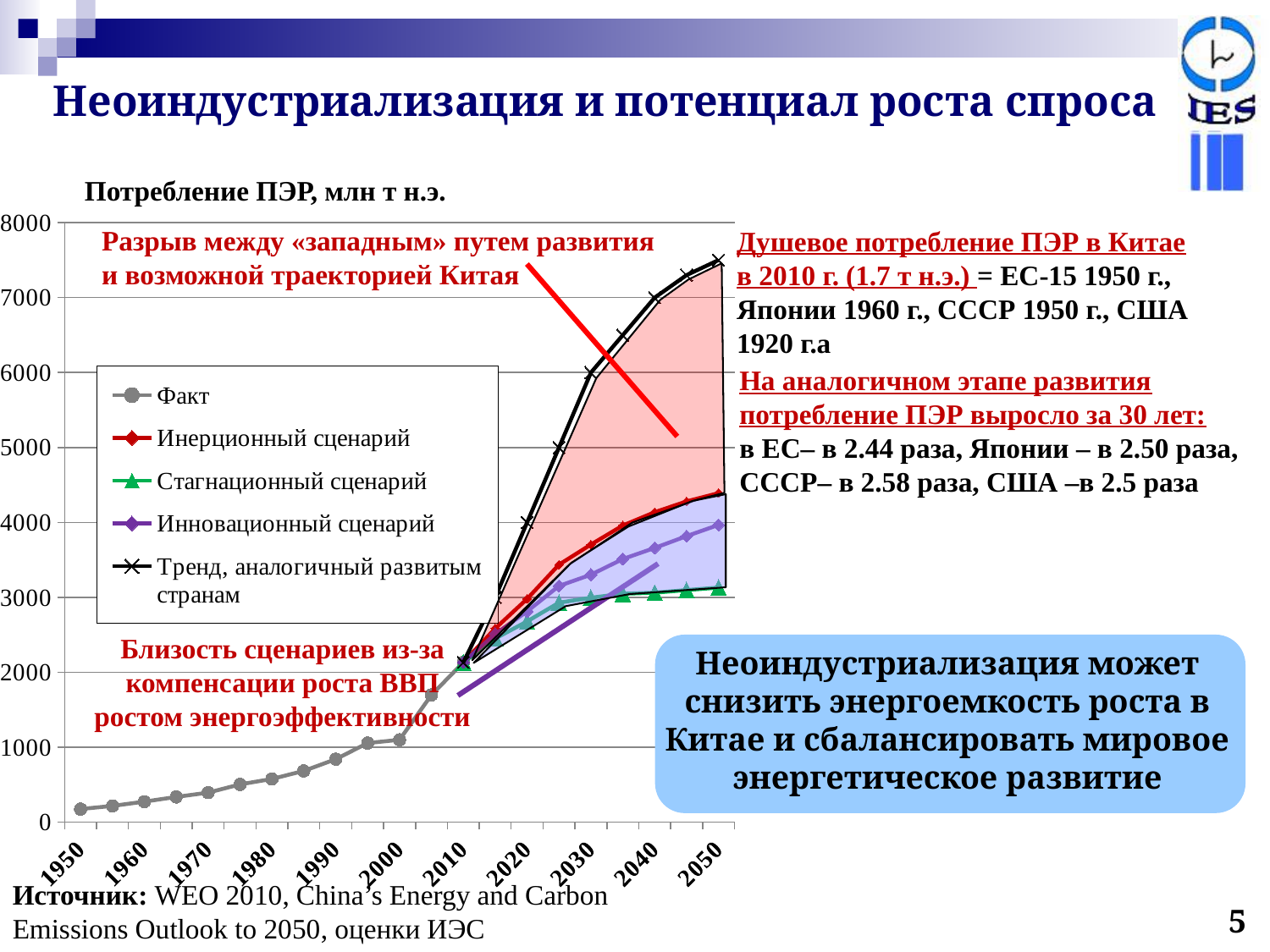
Which legend entry is drawn with a grey line and circle markers? Факт Is the value of the 'Факт' series in 1950 greater or less than 1000? less What kind of chart is shown on the slide? line chart Which series reaches the highest value in 2050? Тренд, аналогичный развитым странам Is the value of the 'Стагнационный сценарий' series in 2050 greater or less than 4000? less Is the value of the 'Инерционный сценарий' series in 2050 greater or less than 4000? greater In 2050, which is larger: the 'Тренд, аналогичный развитым странам' series or the 'Инерционный сценарий' series? Тренд, аналогичный развитым странам Which scenario series has the lowest value in 2050? Стагнационный сценарий How many series does the chart legend list? 5 What is the title of the chart? Потребление ПЭР, млн т н.э. Does the 'Факт' series rise or fall from 1950 to 2010? rise